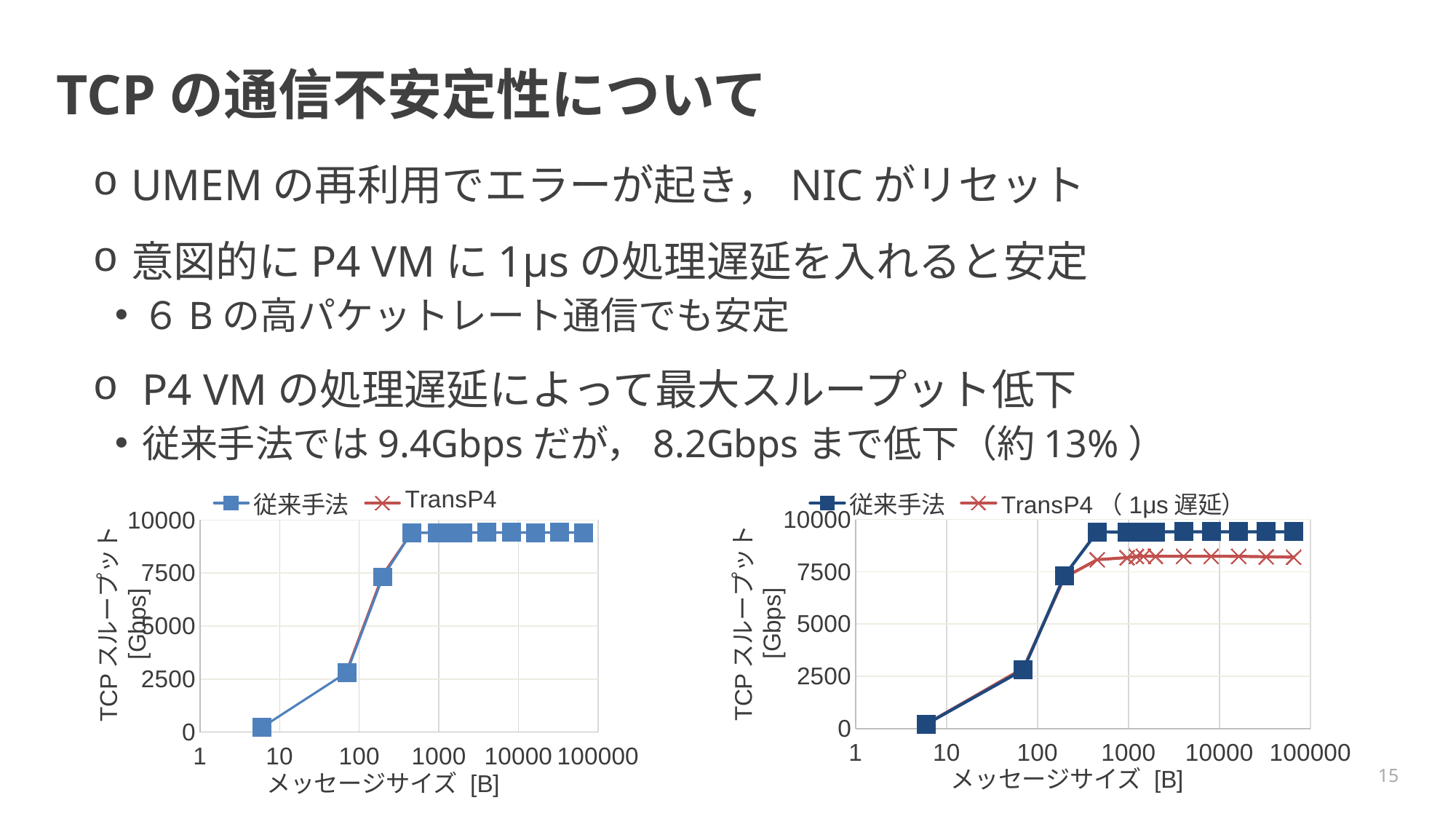
In the left chart, is the 従来手法 value at a message size of 100000 B greater or less than 7500? greater What kind of chart is the right chart on the slide? line chart How many series does the legend of the right chart list? 2 In the right chart, does the 従来手法 throughput rise or fall as message size increases from 10 B to 1000 B? rise In the left chart, is the 従来手法 value at a message size of about 200 B greater or less than 5000? greater In the left chart, is the 従来手法 value at a message size of about 6 B greater or less than 2500? less How many series does the legend of the left chart list? 2 In the right chart, what are the two series named in the legend? 従来手法 and TransP4（1μs 遅延） What is the y-axis label of the left chart? TCP スループット [Gbps] In the right chart, at a message size of 100000 B, which series has the higher TCP throughput, 従来手法 or TransP4（1μs 遅延）? 従来手法 What kind of chart is the left chart on the slide? line chart